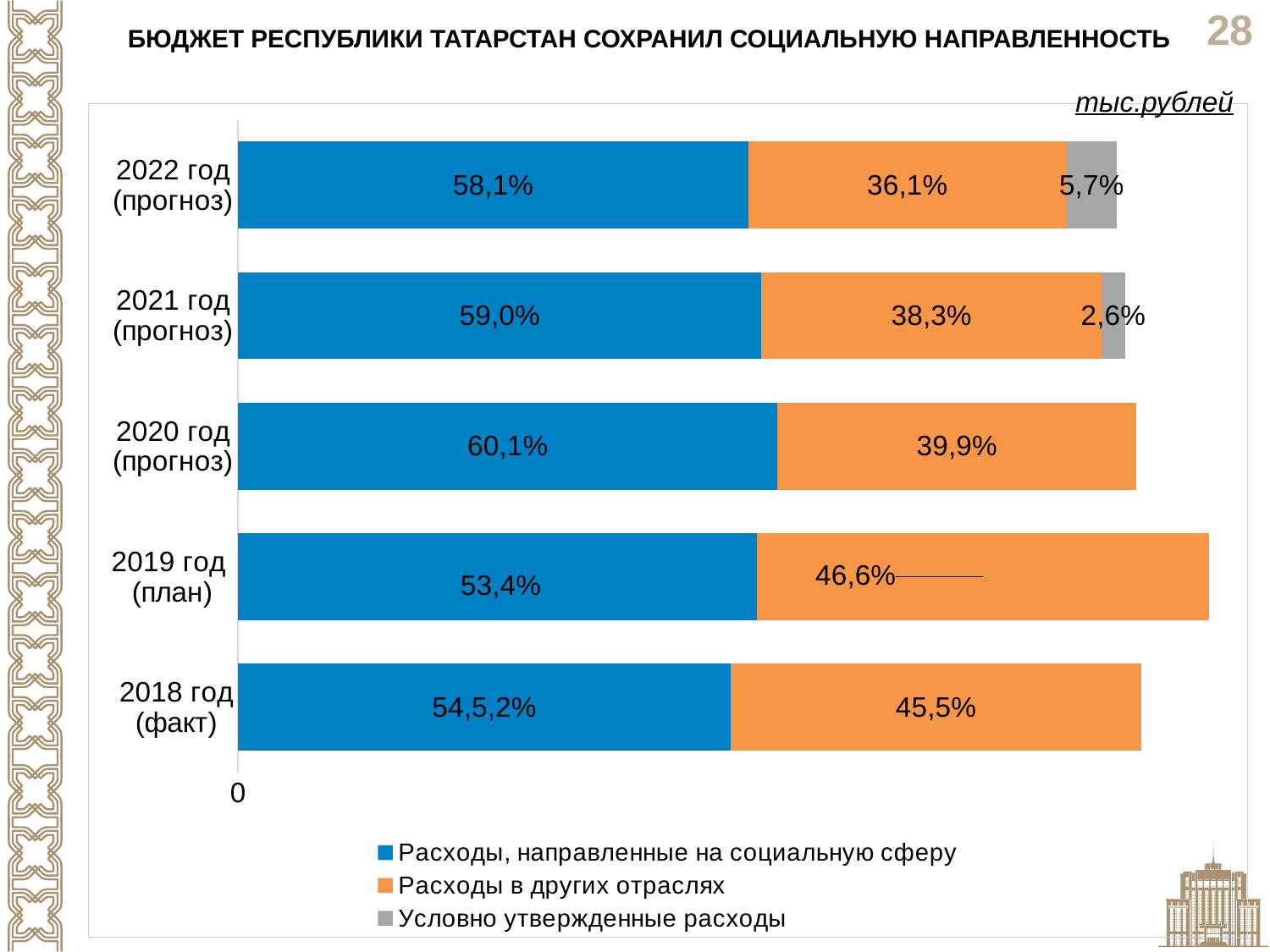
How many series does the legend list? 3 What kind of chart is shown on the slide? Stacked bar chart How many years (categories) are shown on the chart? 5 What is the value for 'Условно утвержденные расходы' in 2022 год (прогноз)? 5,7% Which colour represents 'Условно утвержденные расходы' in the legend? Grey What is the value for 'Расходы в других отраслях' in 2021 год (прогноз)? 38,3% What is the value for 'Расходы в других отраслях' in 2019 год (план)? 46,6% Which year has the highest value for 'Расходы, направленные на социальную сферу'? 2020 год (прогноз) Which is larger: 'Расходы, направленные на социальную сферу' in 2020 год (прогноз) or in 2021 год (прогноз)? 2020 год (прогноз) What is the value for 'Расходы, направленные на социальную сферу' in 2022 год (прогноз)? 58,1% What is the difference between 'Расходы, направленные на социальную сферу' and 'Расходы в других отраслях' in 2022 год (прогноз)? 22,0%